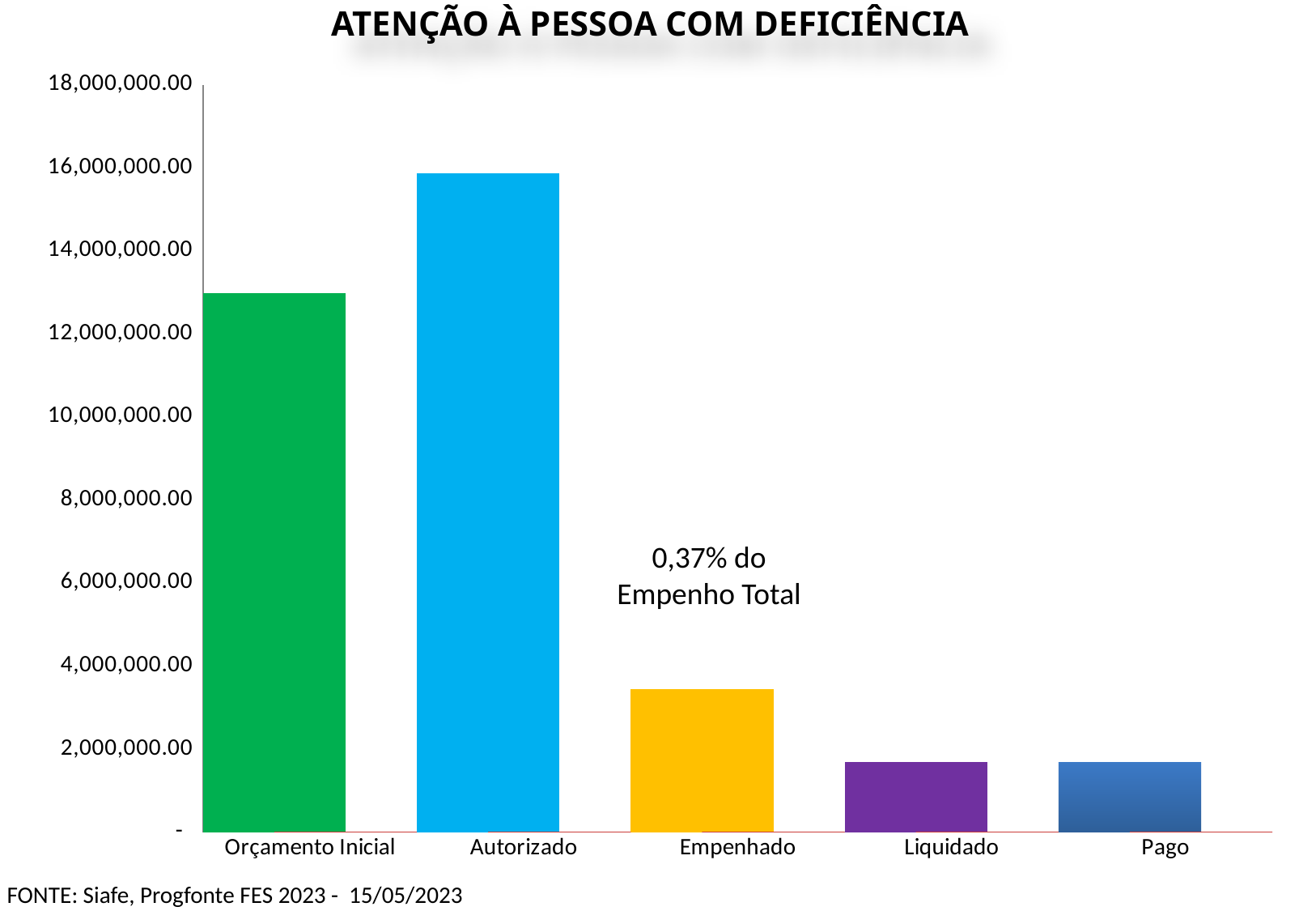
What kind of chart is shown on the slide? bar chart What percentage of the Empenho Total does the annotation on the chart state? 0,37% Is the value for Empenhado greater or less than 4,000,000.00? less Is the value for Pago greater or less than 2,000,000.00? less Which is larger, the value for Empenhado or the value for Liquidado? Empenhado How many categories are shown on the x axis? 5 Is the value for Liquidado greater or less than 2,000,000.00? less Which category has the highest value? Autorizado Which is larger, the value for Orçamento Inicial or the value for Autorizado? Autorizado What is the title of the chart? ATENÇÃO À PESSOA COM DEFICIÊNCIA